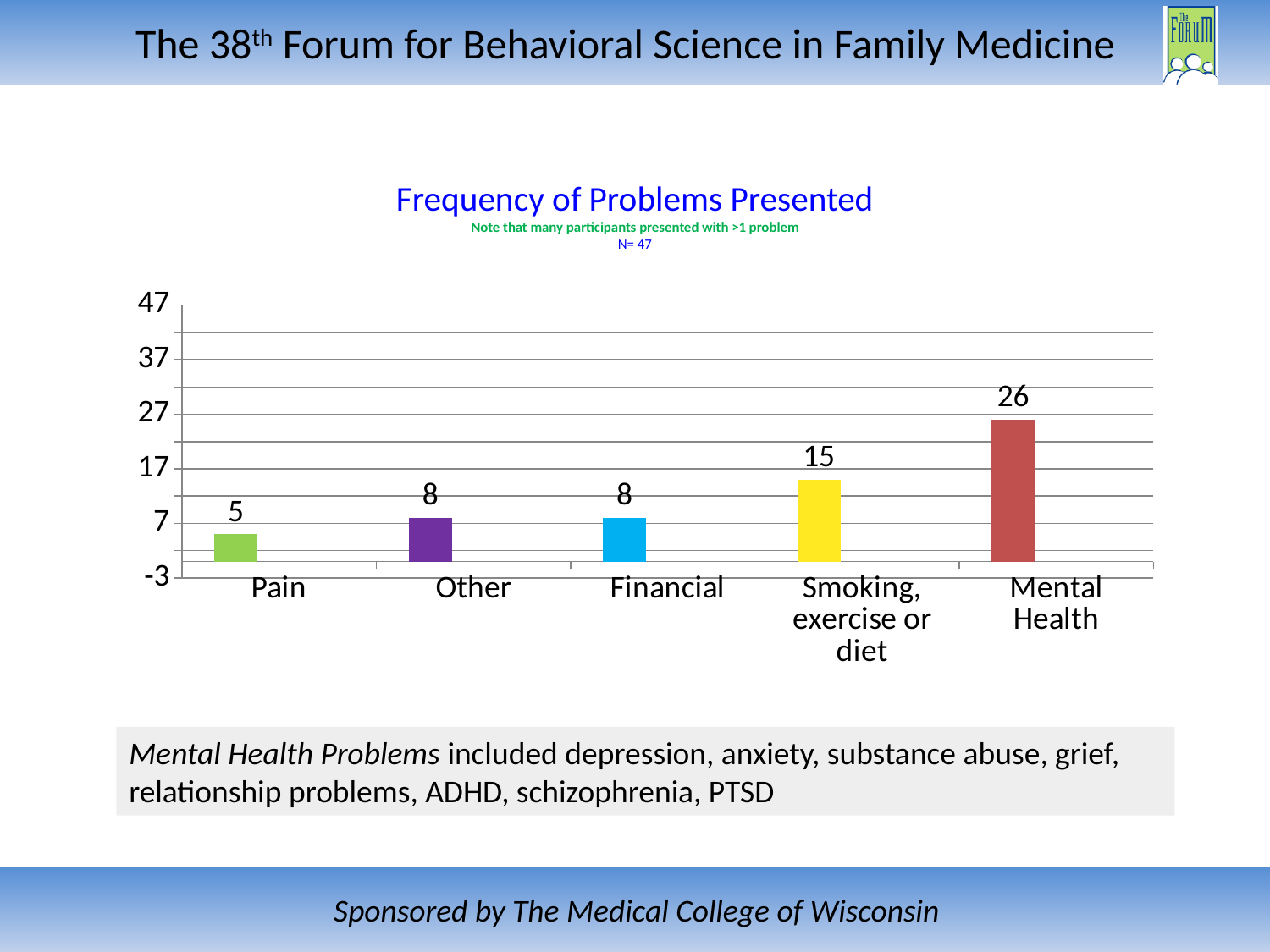
What is the value for Pain? 5 What is the title of the chart? Frequency of Problems Presented What is the difference between the values for Other and Pain? 3 What is the value for Mental Health? 26 Which category has the highest value? Mental Health Which is larger, the value for Financial or the value for Smoking, exercise or diet? Smoking, exercise or diet What is the value for Smoking, exercise or diet? 15 How many categories are shown on the x axis? 5 What kind of chart is shown on the slide? bar chart Which category has the lowest value? Pain Is the value for Mental Health greater or less than 17? greater What is the difference between the values for Mental Health and Smoking, exercise or diet? 11